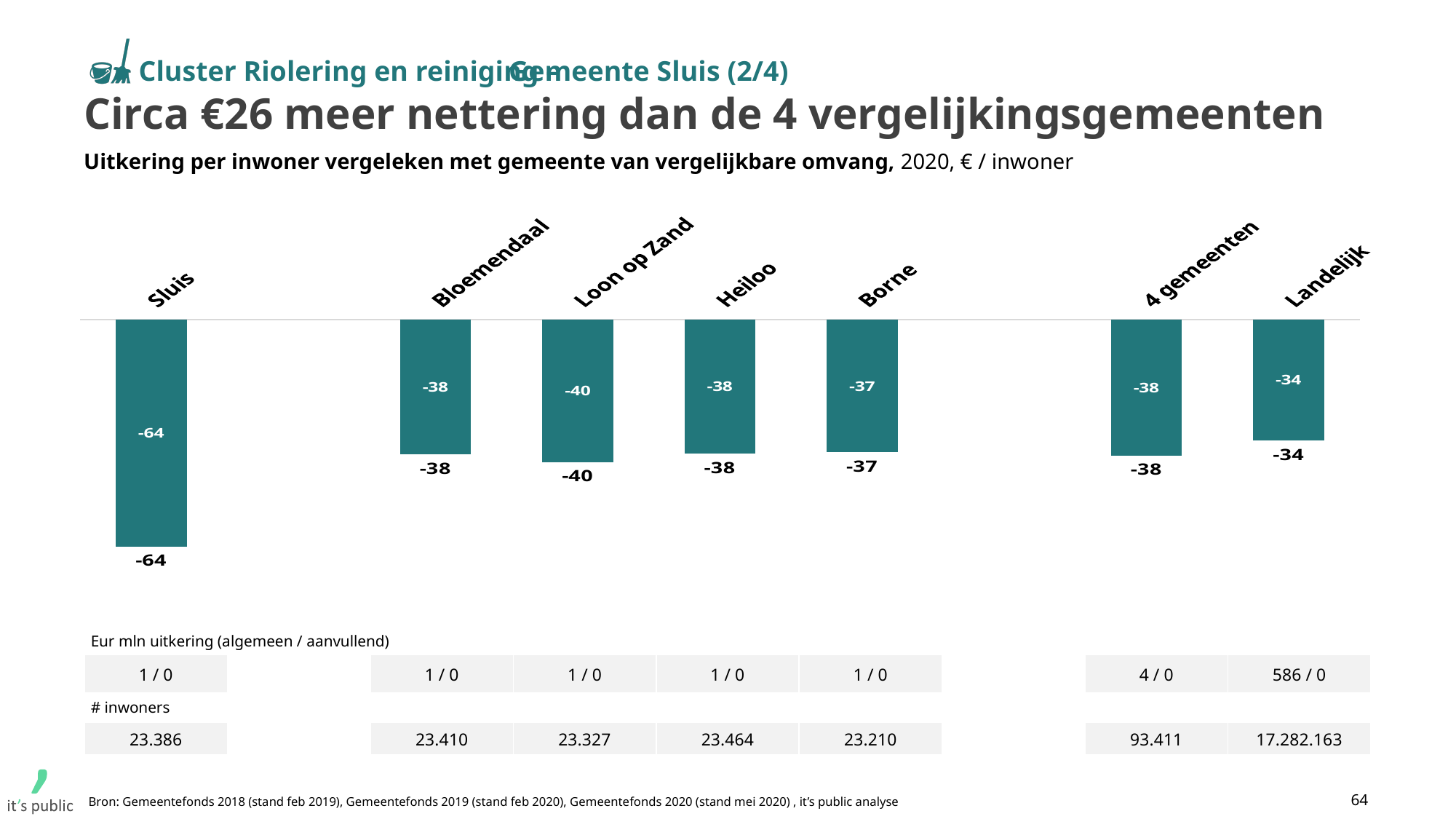
What is the value shown for Sluis? -64 How many categories are plotted in the chart? 7 What is the value shown for Landelijk? -34 Which bar extends further below zero, Loon op Zand or Borne? Loon op Zand What is the value shown for 4 gemeenten? -38 What kind of chart is shown on the slide? Bar chart What unit is stated in the chart subtitle? € / inwoner Which category has the lowest (most negative) value? Sluis What is the value shown for Loon op Zand? -40 Which category has the highest (least negative) value? Landelijk What is the value shown for Borne? -37 What is the difference between the value for Sluis and the value for 4 gemeenten? 26